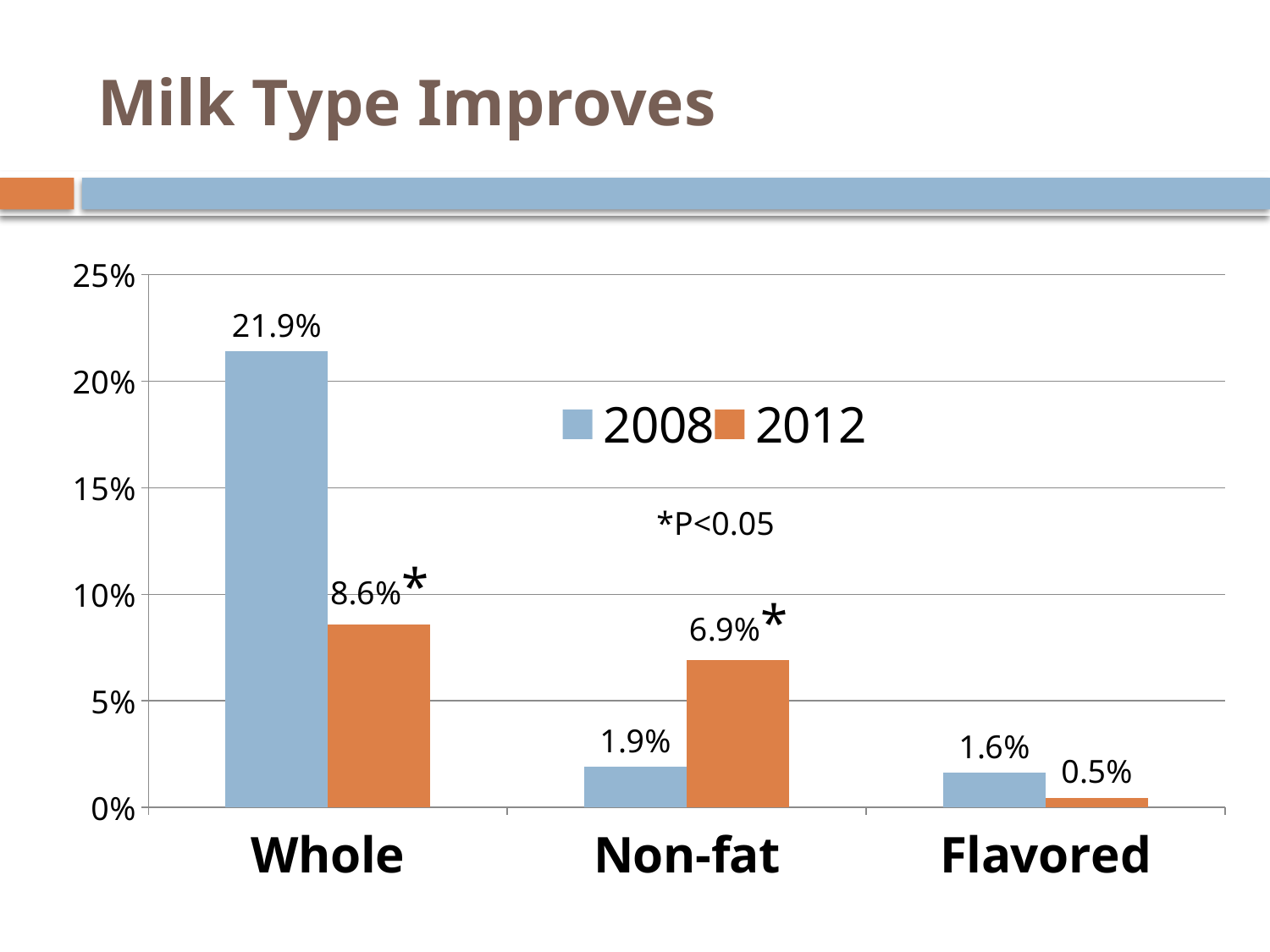
Which milk type has the lowest value in 2012? Flavored Which milk type has the highest value in 2008? Whole What is the value for Non-fat milk in 2012? 6.9% What is the title of the slide? Milk Type Improves How many milk types are shown on the x axis? 3 What is the value for Flavored milk in 2012? 0.5% What kind of chart is shown on the slide? bar chart What is the value for Whole milk in 2008? 21.9% How many series does the legend list? 2 Which is larger for Non-fat milk, the 2008 value or the 2012 value? 2012 What is the difference between the 2008 and 2012 values for Whole milk? 13.3% Is the 2012 value for Whole milk greater or less than 10%? less